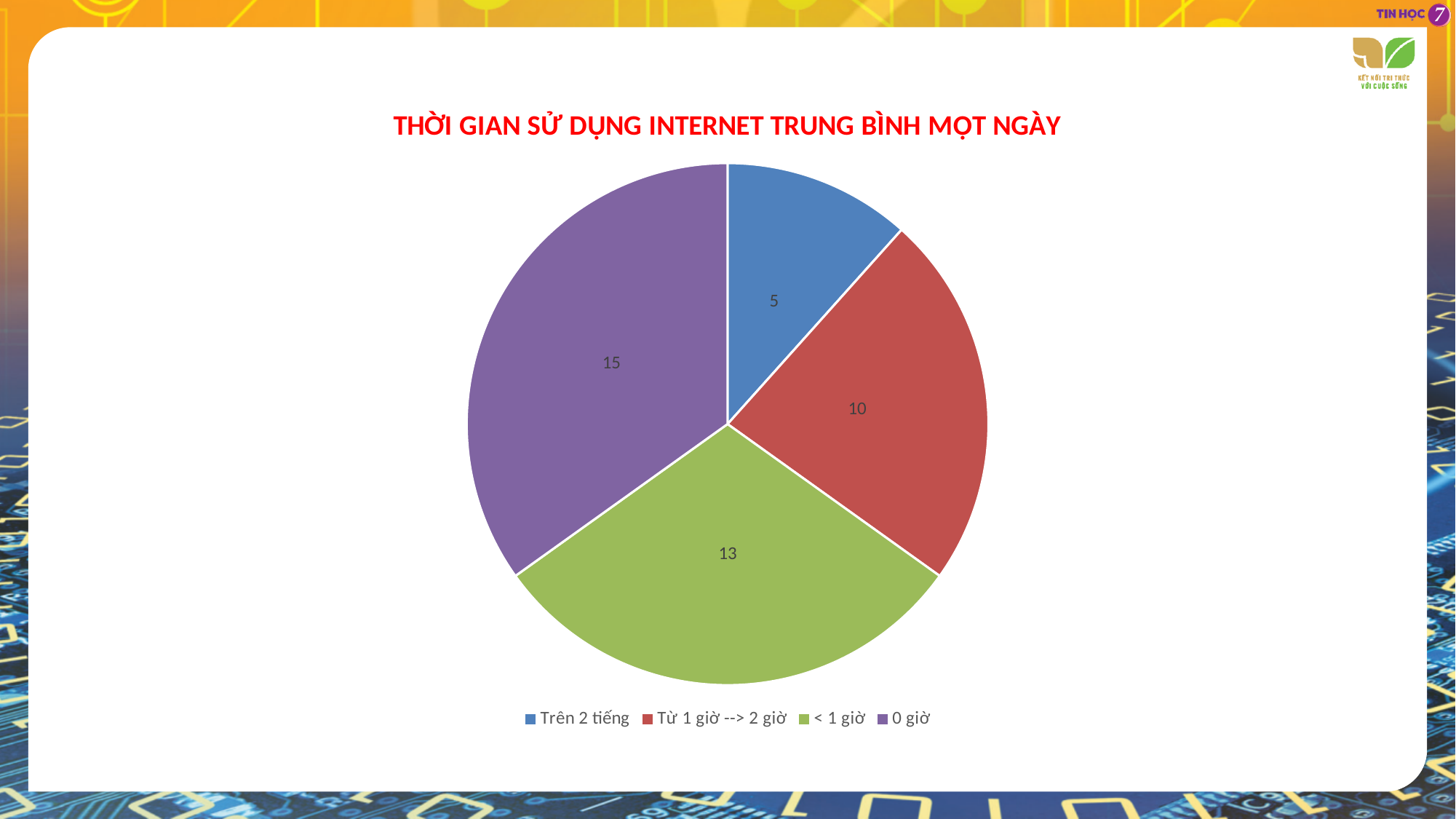
What is the difference between the values for "0 giờ" and "Trên 2 tiếng"? 10 How many slices does the pie chart have? 4 What is the title of the chart? THỜI GIAN SỬ DỤNG INTERNET TRUNG BÌNH MỘT NGÀY What is the value for the "0 giờ" slice? 15 Which category has the largest slice? 0 giờ What is the value for the "Từ 1 giờ --> 2 giờ" slice? 10 What colour is the "0 giờ" slice? Purple What is the value for the "< 1 giờ" slice? 13 What kind of chart is shown on the slide? Pie chart Which category has the smallest slice? Trên 2 tiếng Which is larger, the value for "< 1 giờ" or the value for "Từ 1 giờ --> 2 giờ"? < 1 giờ What is the value for the "Trên 2 tiếng" slice? 5